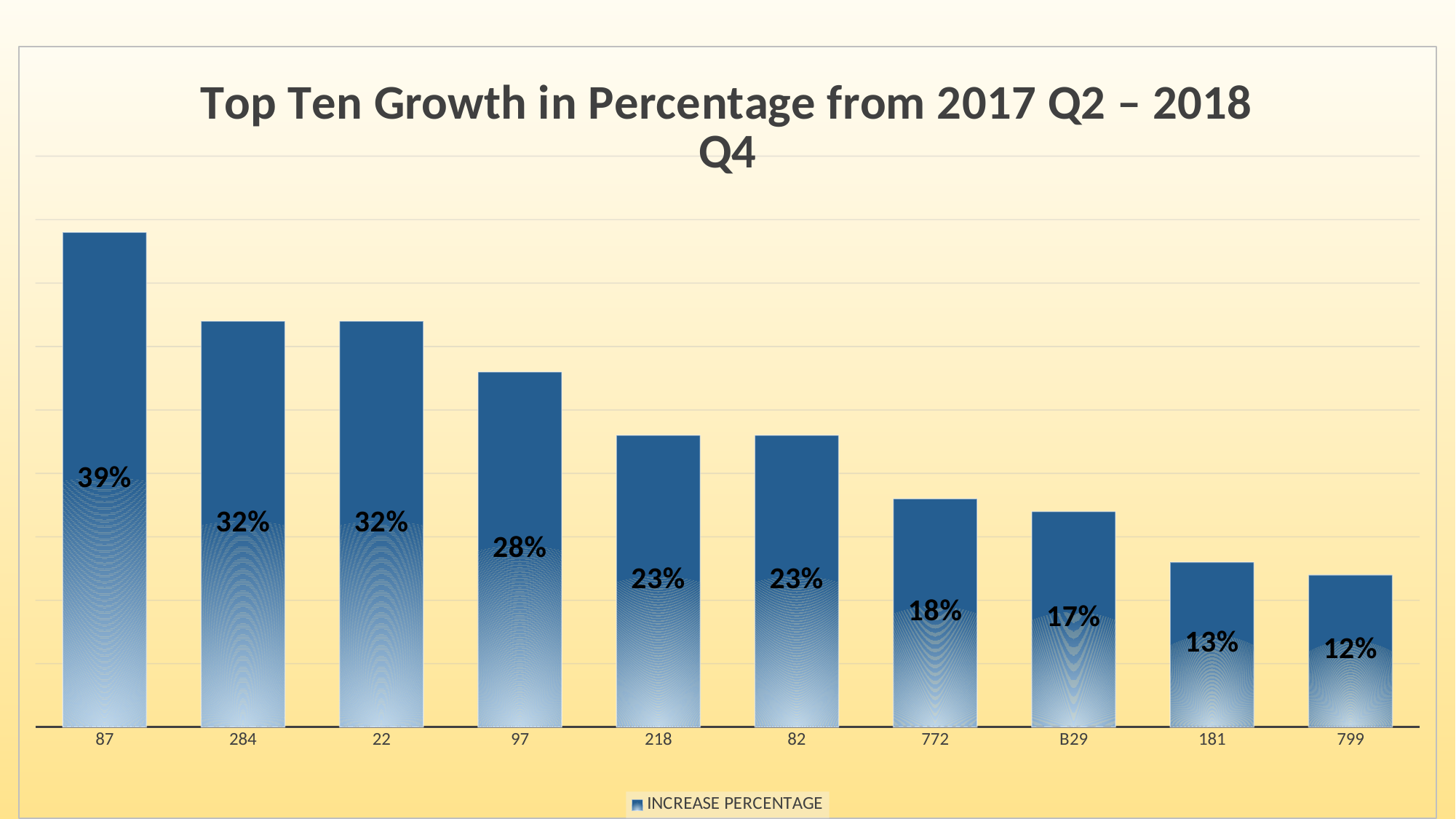
What is the difference between the increase percentage for 87 and for 284? 7% What is the increase percentage for category B29? 17% What type of chart is shown on the slide? Bar chart Which category has the lowest increase percentage? 799 What is the title of the chart? Top Ten Growth in Percentage from 2017 Q2 – 2018 Q4 How many categories are shown in the chart? 10 Which category has the highest increase percentage? 87 What is the difference between the increase percentage for 772 and for 181? 5% What is the increase percentage for category 97? 28% What is the increase percentage for category 87? 39% What is the increase percentage for category 799? 12% Which has a larger increase percentage, 97 or 218? 97